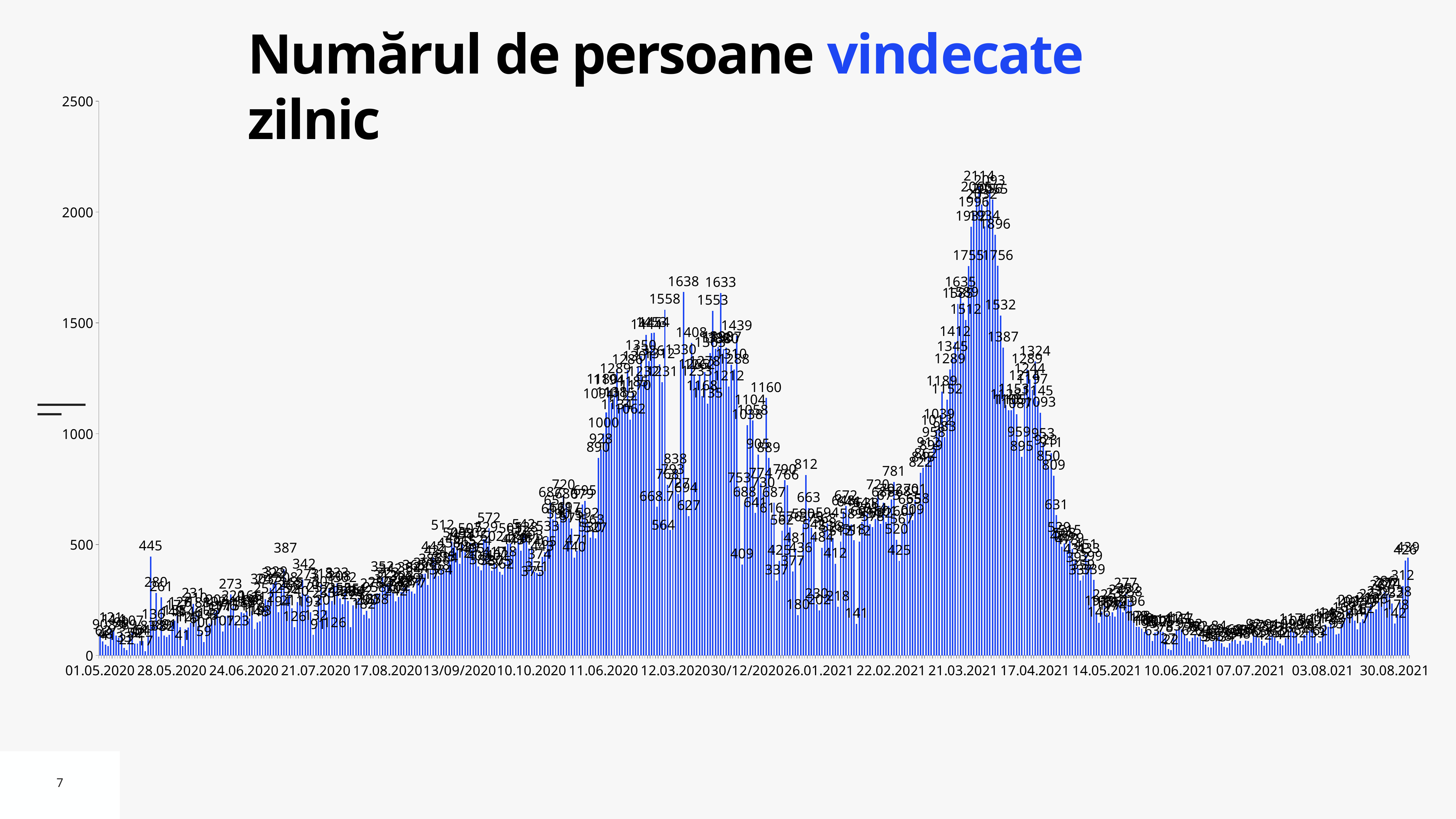
What is the last date label on the horizontal axis? 30.08.2021 Are the bars around 07.07.2021 greater or less than 500? less What is the difference between the highest data label, 2114, and the label 1896 just below the peak? 218 Do the values rise or fall between 17.04.2021 and 10.06.2021? fall What is the highest data label shown on the chart? 2114 Which is larger: the bar labeled 1638 or the bar labeled 2114? 2114 What is the highest value shown on the vertical axis? 2500 Do the values rise or fall between 03.08.2021 and 30.08.2021? rise Is the tallest bar on the chart greater or less than 2000? greater What is the title of the chart? Numărul de persoane vindecate zilnic What is the first date label on the horizontal axis? 01.05.2020 What kind of chart is shown on the slide? bar chart